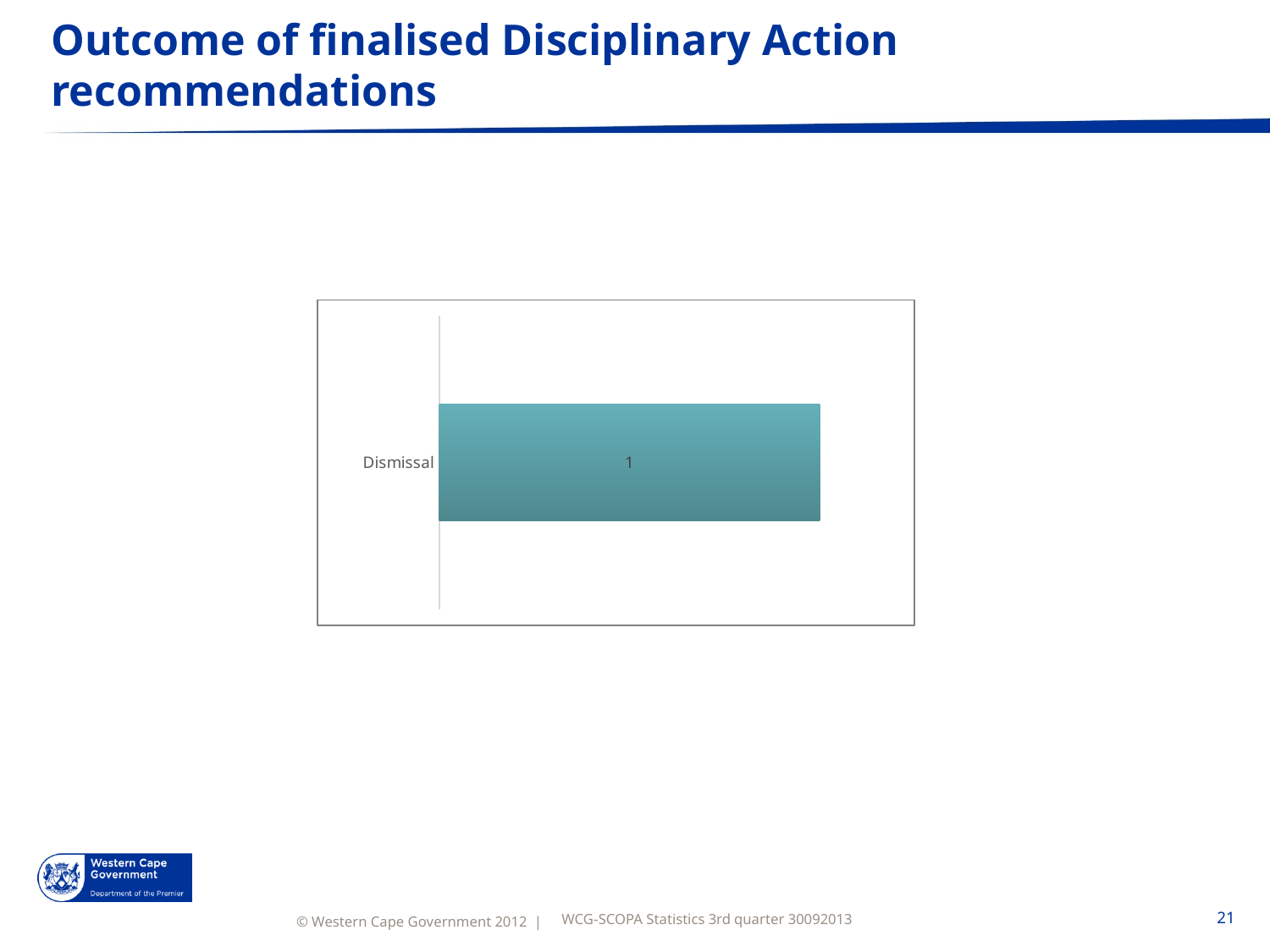
How many categories are plotted in the chart? 1 What kind of chart is shown on the slide? bar chart Are the bars in the chart horizontal or vertical? horizontal What is the label of the only category shown in the chart? Dismissal What is the value for Dismissal? 1